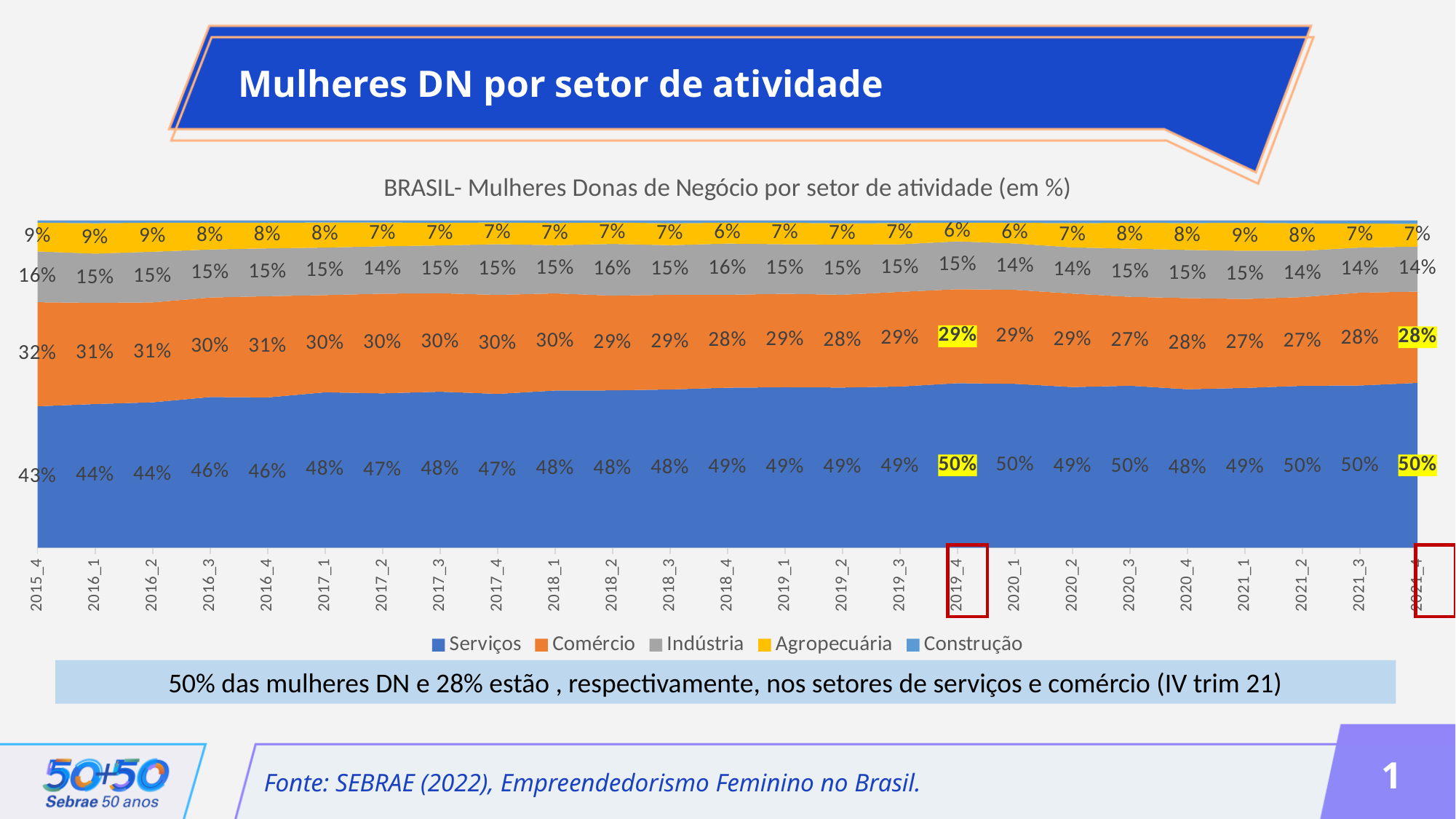
Which is larger in 2021_4, Serviços or Comércio? Serviços What is the value for Indústria in 2015_4? 16% In which quarter is the Comércio value highest? 2015_4 How many quarters (x-axis points) are plotted in the chart? 25 In which quarter is the Serviços value lowest? 2015_4 How many series does the legend list? 5 Does the Comércio share generally rise or fall from 2015_4 to 2021_4? Fall What is the value for Comércio in 2019_4? 29% What is the value for Serviços in 2021_4? 50% What is the difference between the Serviços and Comércio values in 2021_4? 22 percentage points What kind of chart is shown on the slide? Stacked area chart What is the value for Agropecuária in 2018_4? 6%